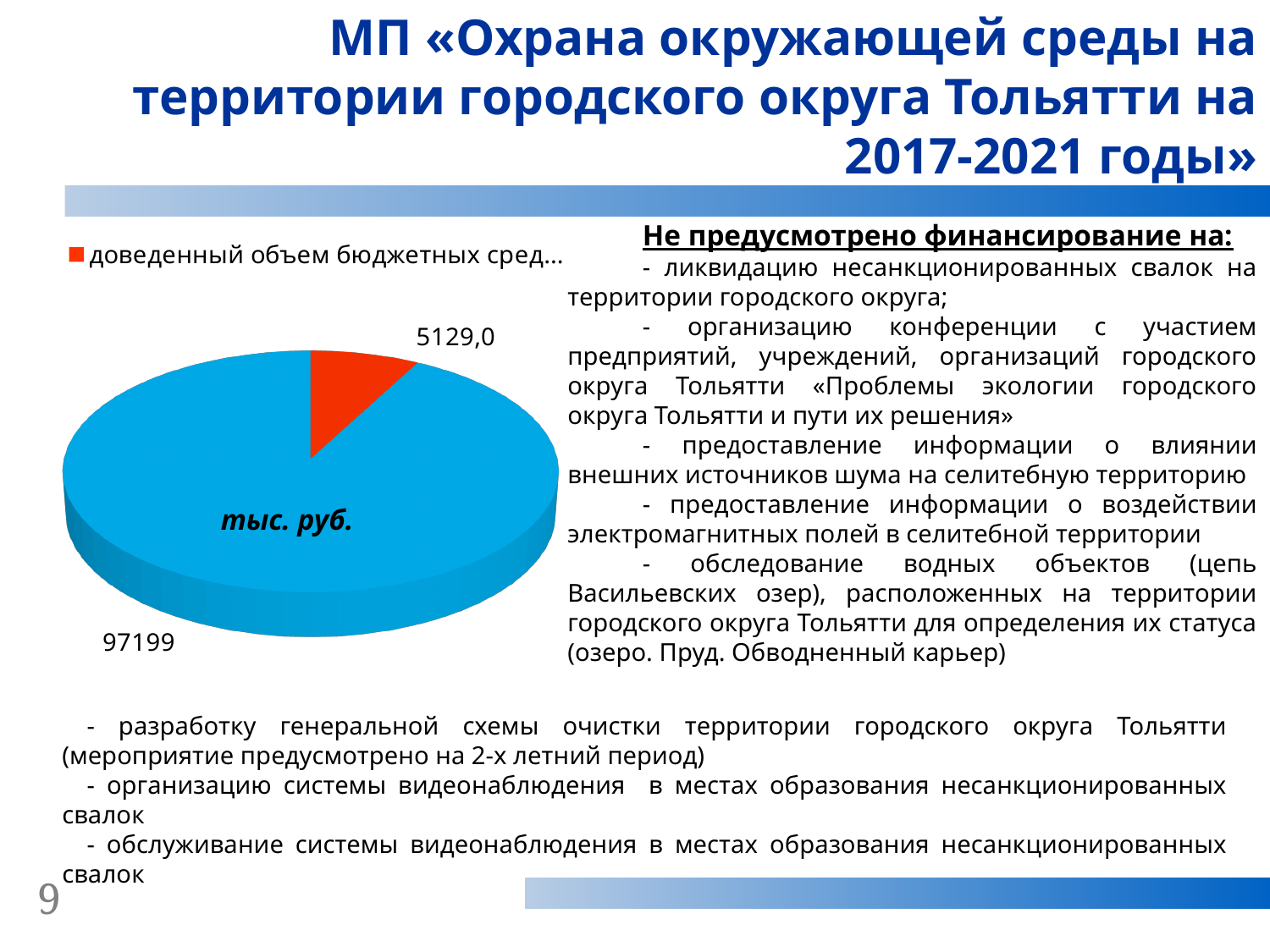
What is the total of the two values shown in the pie chart? 102328 What value is printed on the small red slice of the pie chart? 5129,0 How many entries does the legend of the pie chart list? 1 What kind of chart is shown on the slide? pie chart What unit label is printed inside the pie chart? тыс. руб. What is the difference between the blue slice value (97199) and the red slice value (5129,0)? 92070 Which slice of the pie chart is the smallest? the red slice (5129,0) How many slices does the pie chart have? 2 Which slice of the pie chart is the largest? the blue slice (97199) Which is larger in the pie chart: the red slice or the blue slice? the blue slice What value is printed on the large blue slice of the pie chart? 97199